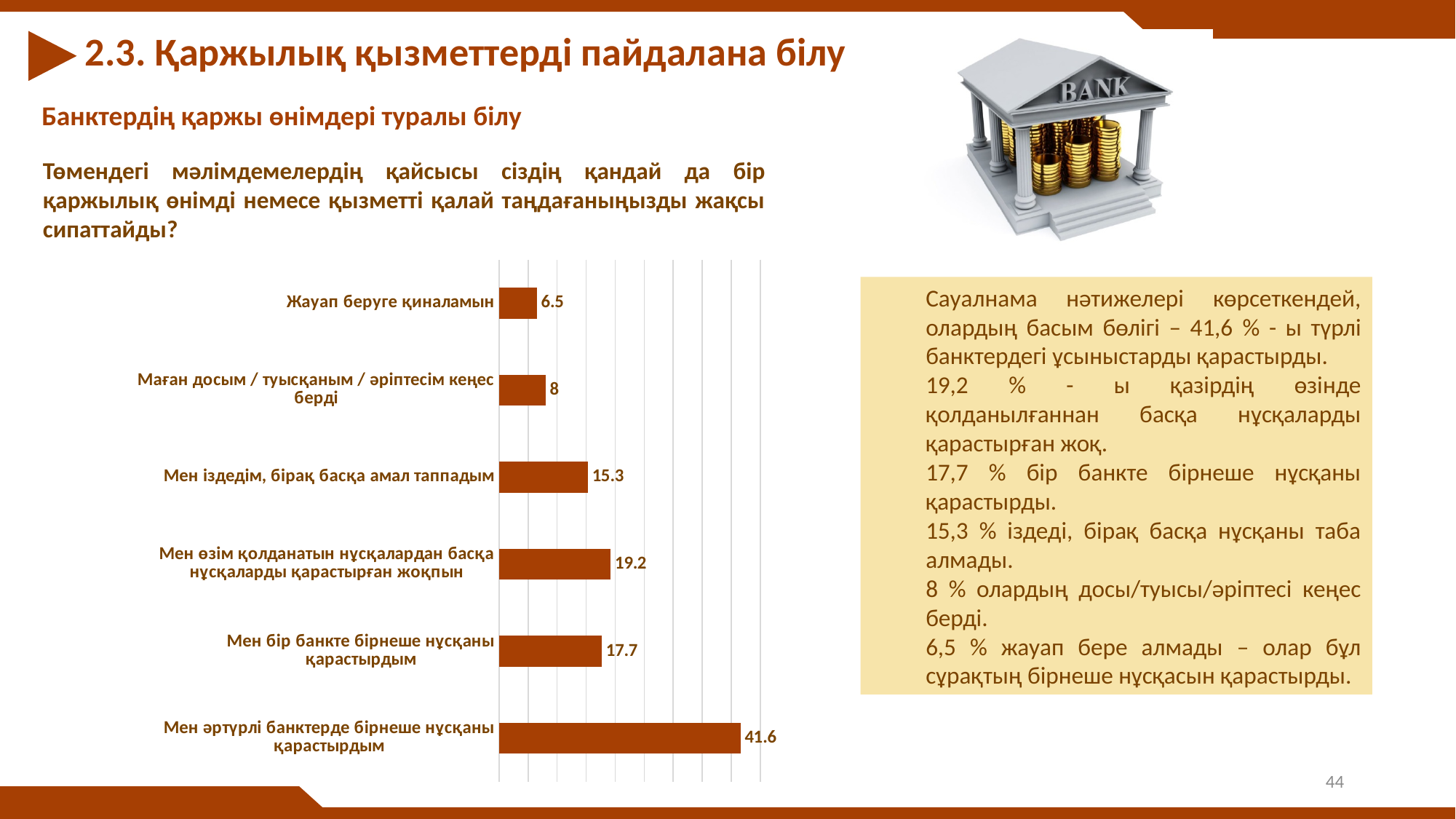
What is the difference between the values for "Мен өзім қолданатын нұсқалардан басқа нұсқаларды қарастырған жоқпын" and "Мен бір банкте бірнеше нұсқаны қарастырдым"? 1.5 What value is shown for "Мен әртүрлі банктерде бірнеше нұсқаны қарастырдым"? 41.6 Which category has the lowest value in the chart? Жауап беруге қиналамын What value is shown for "Мен бір банкте бірнеше нұсқаны қарастырдым"? 17.7 What colour are the bars in the chart? Brown (dark orange) Which category has the highest value in the chart? Мен әртүрлі банктерде бірнеше нұсқаны қарастырдым Which is larger: the value for "Мағаn досым / туысқаным / әріптесім кеңес берді" or the value for "Жауап беруге қиналамын"? Маған досым / туысқаным / әріптесім кеңес берді What type of chart is shown on the slide? Bar chart How many categories are shown in the chart? 6 What value is shown for "Жауап беруге қиналамын"? 6.5 What is the difference between the values for "Мен әртүрлі банктерде бірнеше нұсқаны қарастырдым" and "Мен іздедім, бірақ басқа амал таппадым"? 26.3 What value is shown for "Мен іздедім, бірақ басқа амал таппадым"? 15.3